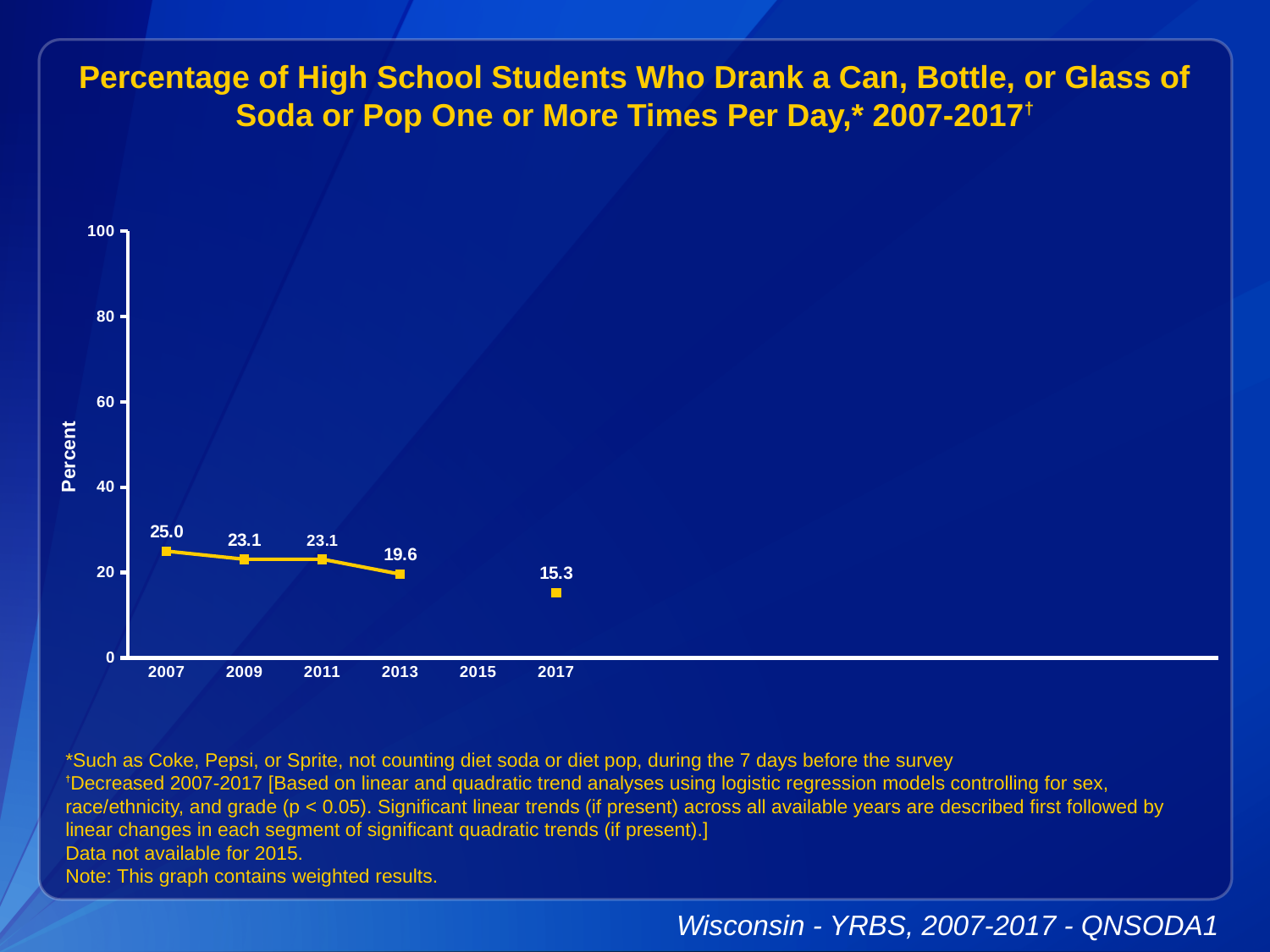
What kind of chart is shown on the slide? line chart What is the value plotted for 2013? 19.6 How many years have a data point plotted on the chart? 5 What is the difference between the 2007 value and the 2017 value? 9.7 What is the value plotted for 2017? 15.3 Which is larger, the value for 2009 or the value for 2013? 2009 Which year has the lowest plotted percentage? 2017 Is the value for 2017 greater or less than 20? less Which year has the highest percentage? 2007 What is the label on the y axis? Percent Do the values rise or fall from 2007 to 2017? fall What percentage of high school students drank soda or pop one or more times per day in 2007? 25.0